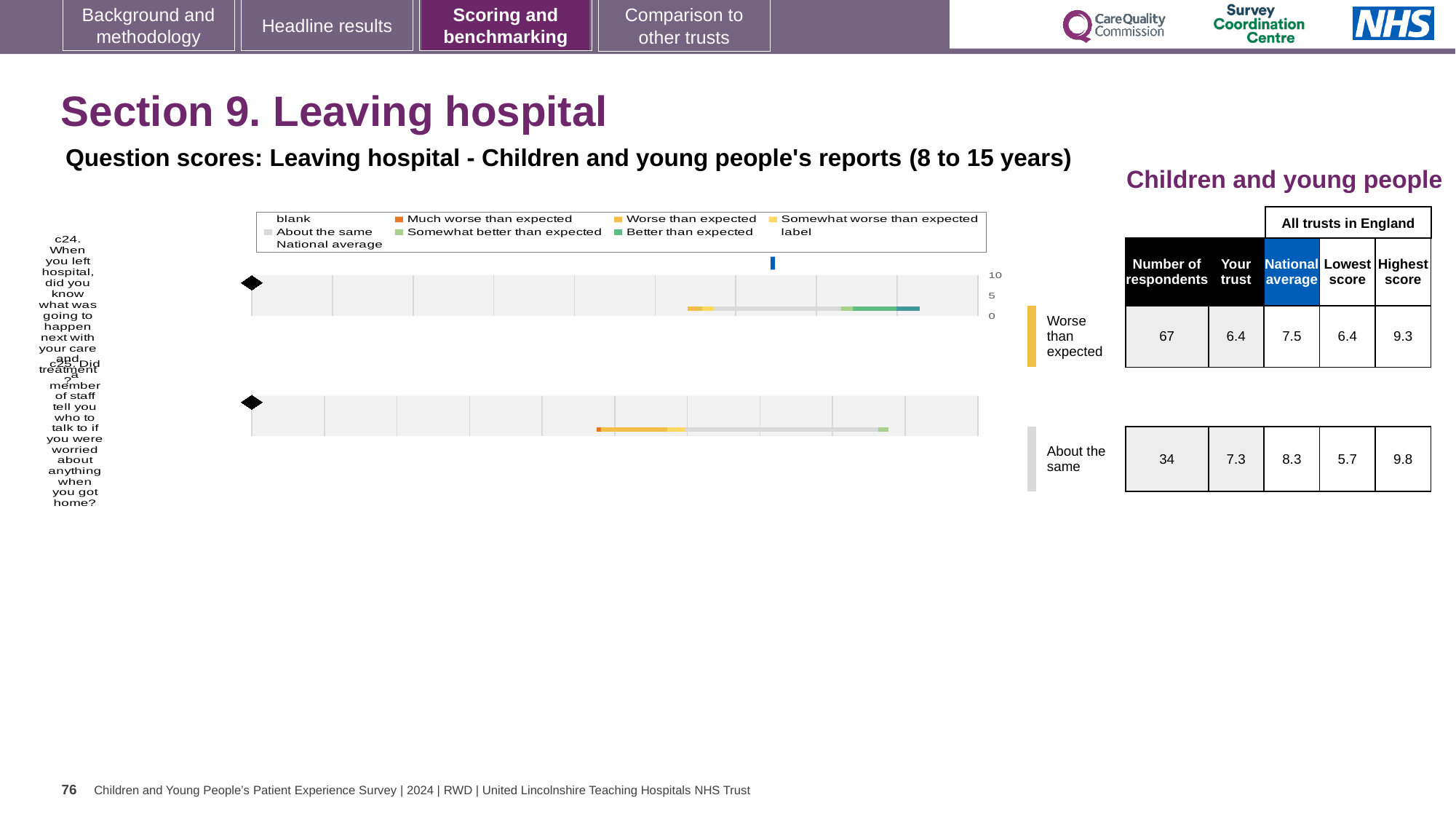
What is the national average score for question c25 (Did a member of staff tell you who to talk to if you were worried about anything when you got home?)? 8.3 What is the highest score among all trusts in England for question c25? 9.8 What is the 'Your trust' score for question c24? 6.4 What benchmark category is shown for question c25? About the same What kind of chart is used to show the question scores for Leaving hospital? bar chart What benchmark category is shown for question c24? Worse than expected How many respondents answered question c24 (When you left hospital, did you know what was going to happen next with your care and treatment?)? 67 How many questions are plotted in the Leaving hospital chart? 2 By how much is the national average higher than the trust's score for question c24? 1.1 What colour represents 'Much worse than expected' in the chart legend? orange What is the lowest score among all trusts in England for question c24? 6.4 Which question has the higher 'Your trust' score, c24 or c25? c25